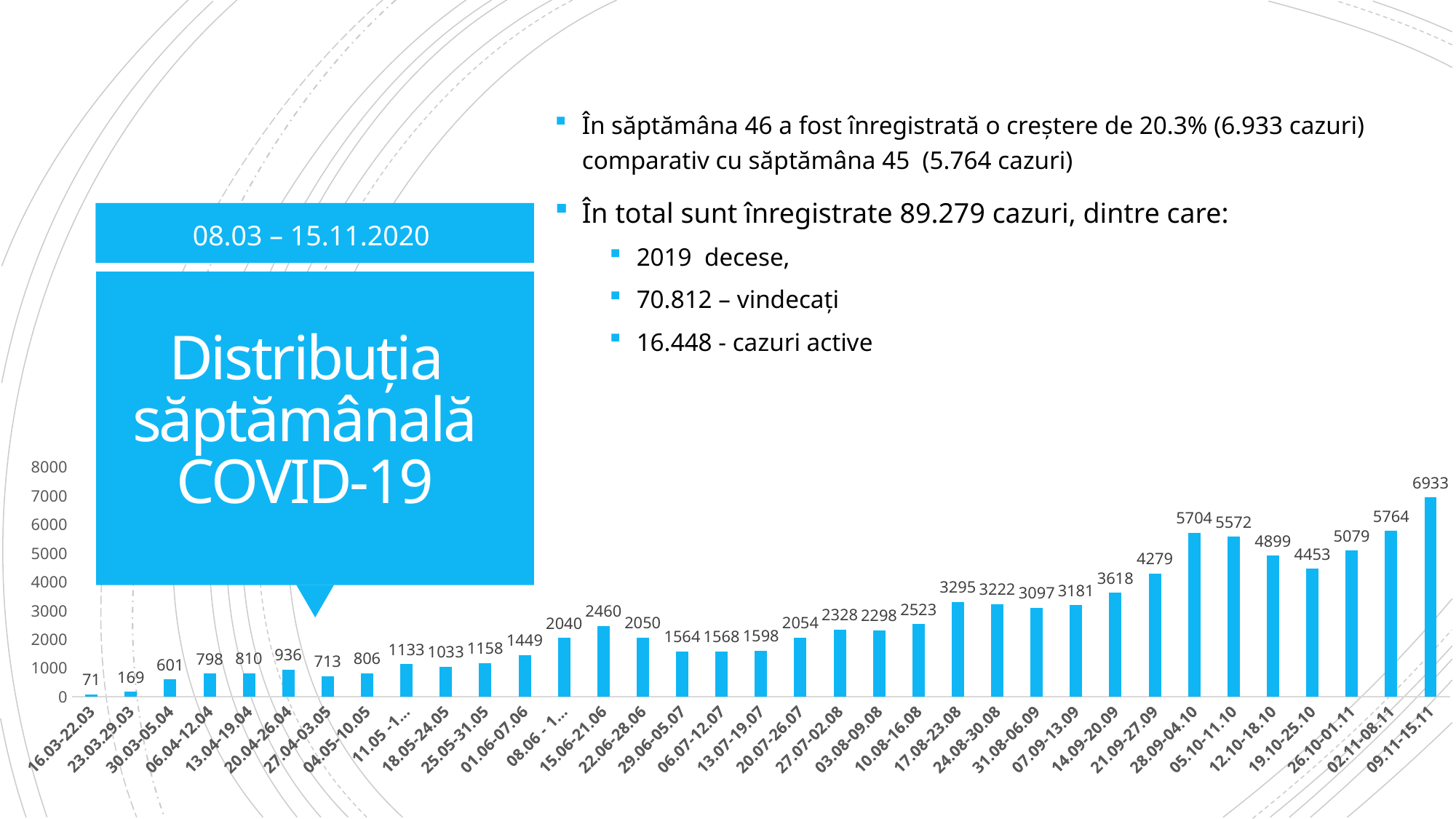
Which is larger, the value for 12.10-18.10 or the value for 19.10-25.10? 12.10-18.10 What is the highest value shown on the vertical axis of the chart? 8000 What value is shown for the week 15.06-21.06? 2460 Which week has the lowest value in the chart? 16.03-22.03 What is the difference between the values for 09.11-15.11 and 02.11-08.11? 1169 What type of chart is shown on the slide? bar chart Which week has the highest value in the chart? 09.11-15.11 Is the value for 14.09-20.09 greater or less than 3000? greater How many weekly bars are plotted in the chart? 35 What value is shown for the week 09.11-15.11? 6933 What is the difference between the values for 28.09-04.10 and 21.09-27.09? 1425 What value is shown for the week 28.09-04.10? 5704